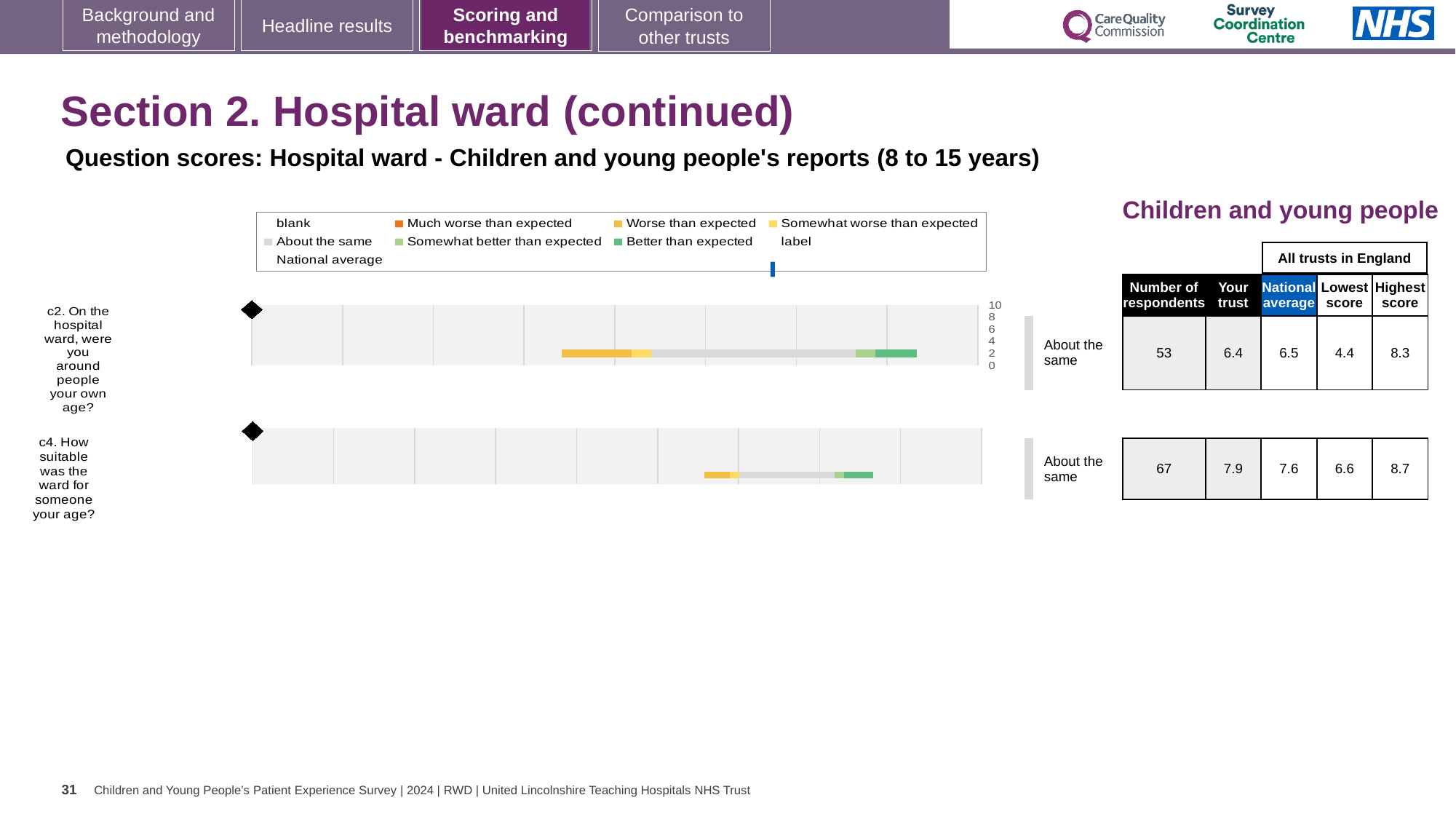
Which question has the higher 'Your trust' score, c2 or c4? c4 What is the 'Your trust' score for question c2 (On the hospital ward, were you around people your own age?)? 6.4 In the chart legend, which category is shown in orange? Much worse than expected What is the national average score for question c4? 7.6 What is the highest score across all trusts in England for question c2? 8.3 What is the difference between the 'Your trust' score and the national average for question c4? 0.3 How many respondents answered question c4 (How suitable was the ward for someone your age?)? 67 What is the difference between the highest and lowest scores across all trusts for question c2? 3.9 What is the lowest score across all trusts in England for question c4? 6.6 How many survey questions are plotted on the slide's benchmarking chart? 2 What kind of chart is used to show the benchmarking for questions c2 and c4? bar chart What benchmark category is given for question c2? About the same